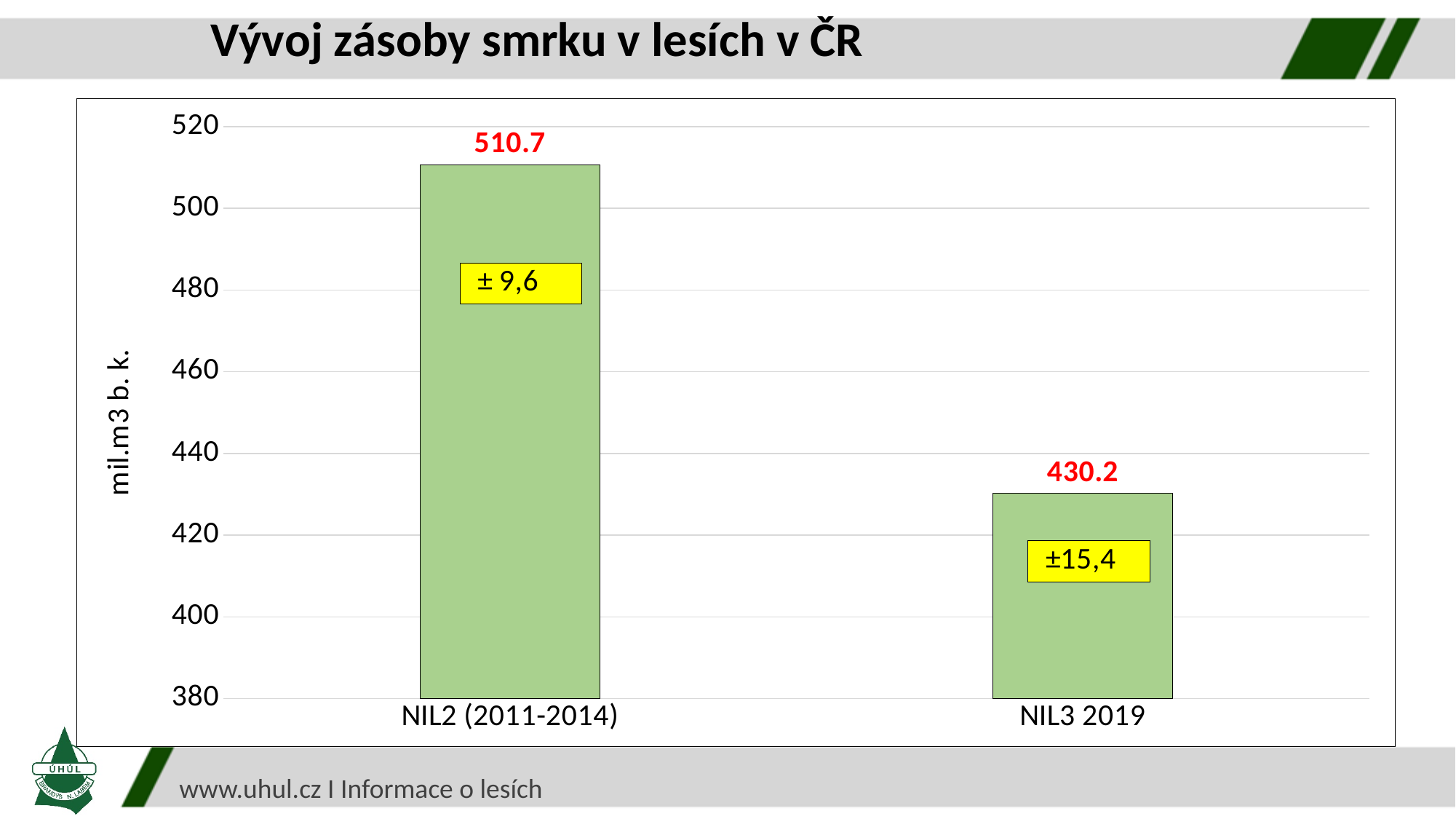
What kind of chart is shown on the slide? bar chart What is the difference between the values for NIL2 (2011-2014) and NIL3 2019? 80.5 Is the value for NIL2 (2011-2014) greater or less than 500? greater What is the value for NIL3 2019? 430.2 Is the value for NIL3 2019 greater or less than 440? less Do the values rise or fall from NIL2 (2011-2014) to NIL3 2019? fall Which category has the lowest value? NIL3 2019 Which category has the highest value? NIL2 (2011-2014) How many categories are shown on the chart? 2 What is the label on the vertical axis of the chart? mil.m3 b. k. Which is larger, the value for NIL2 (2011-2014) or the value for NIL3 2019? NIL2 (2011-2014) What is the value for NIL2 (2011-2014)? 510.7